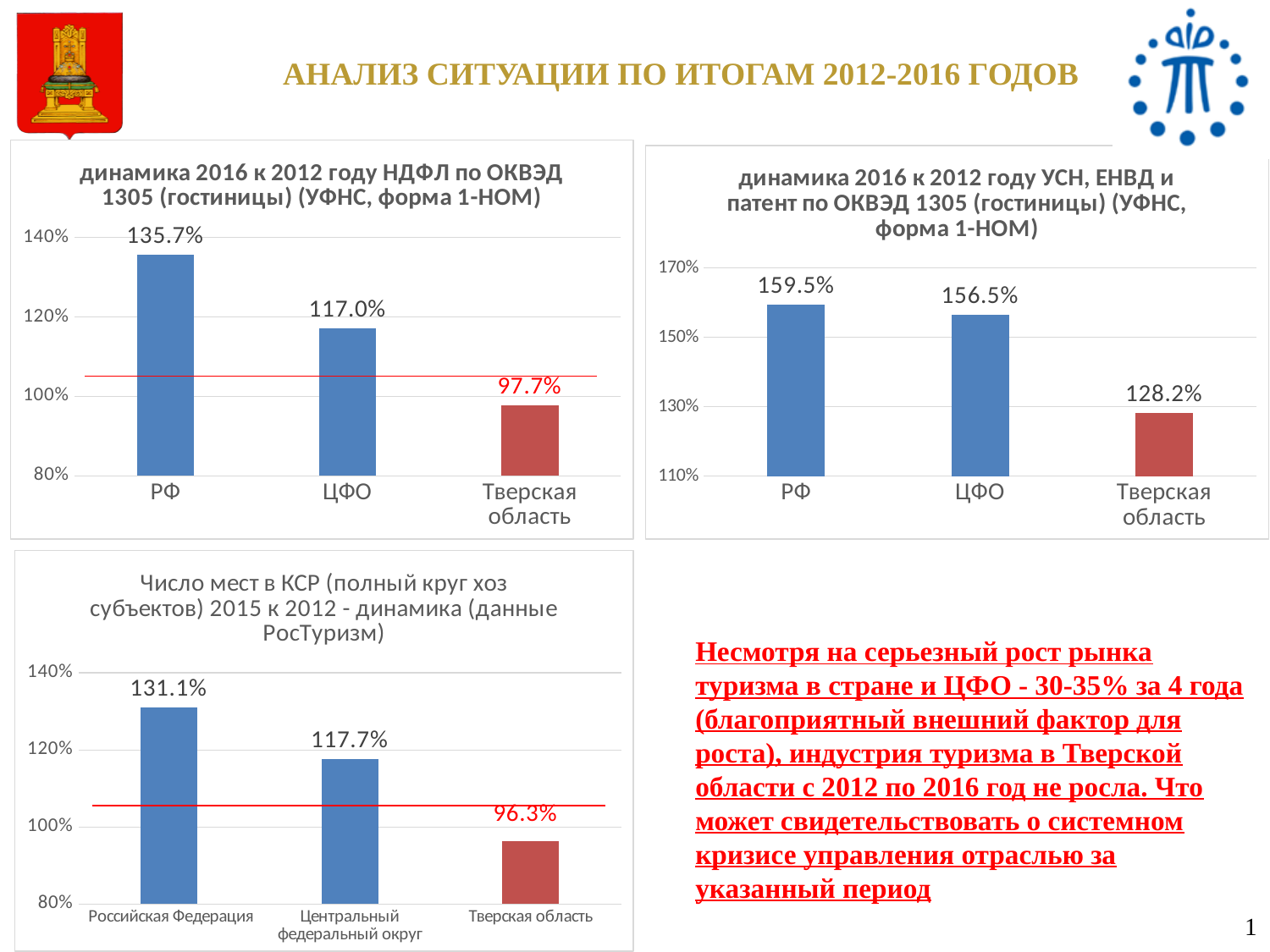
In the top-left chart (динамика 2016 к 2012 году НДФЛ по ОКВЭД 1305), which category has the lowest value? Тверская область In the bottom-left chart (Число мест в КСР 2015 к 2012), is the value for Тверская область greater or less than 100%? less In the top-left chart (динамика 2016 к 2012 году НДФЛ по ОКВЭД 1305), what is the value for Тверская область? 97.7% What type of chart is the top-right chart (динамика 2016 к 2012 году УСН, ЕНВД и патент)? bar chart In the top-left chart (динамика 2016 к 2012 году НДФЛ по ОКВЭД 1305), what is the value for РФ? 135.7% In the bottom-left chart (Число мест в КСР 2015 к 2012), which is larger: the value for Российская Федерация or the value for Тверская область? Российская Федерация In the top-right chart (динамика 2016 к 2012 году УСН, ЕНВД и патент), what is the difference between the values for РФ and Тверская область? 31.3% In the top-right chart (динамика 2016 к 2012 году УСН, ЕНВД и патент), what is the value for ЦФО? 156.5% How many categories are shown in the bottom-left chart (Число мест в КСР 2015 к 2012)? 3 In the top-right chart (динамика 2016 к 2012 году УСН, ЕНВД и патент), which category has the highest value? РФ In the bottom-left chart (Число мест в КСР 2015 к 2012), what is the value for Центральный федеральный округ? 117.7% In the top-left chart (динамика 2016 к 2012 году НДФЛ по ОКВЭД 1305), what is the difference between the values for РФ and ЦФО? 18.7%